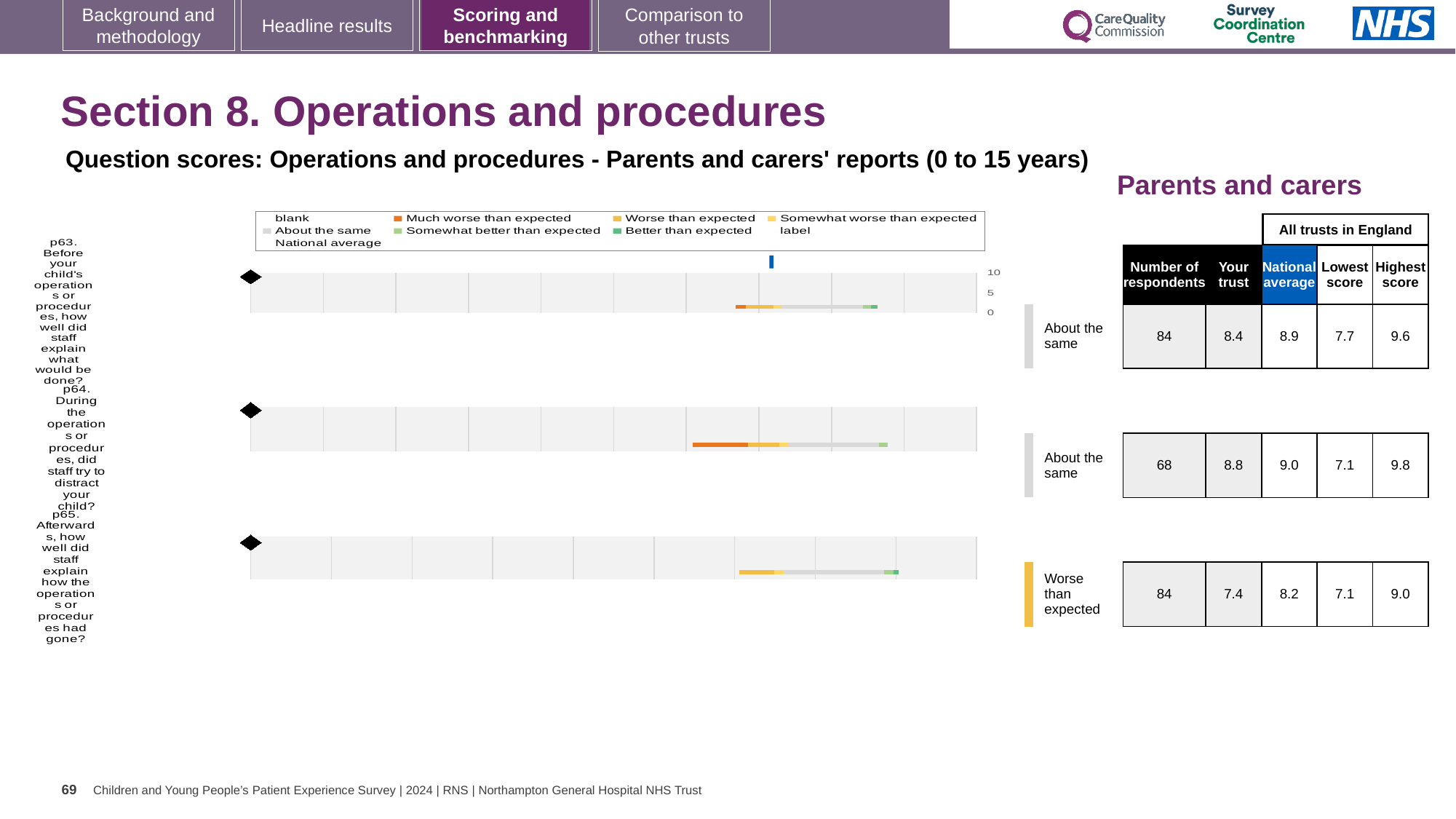
What is the highest value shown on the chart's score axis? 10 Which of the three questions has the highest 'Your trust' score? p64 What is the national average score for p64 (During the operations or procedures, did staff try to distract your child?)? 9.0 What is the difference between the national average and the 'Your trust' score for p65? 0.8 What is the 'Your trust' score for p63 (Before your child's operations or procedures, how well did staff explain what would be done?)? 8.4 Which benchmark category is shown for p65 (Afterwards, how well did staff explain how the operations or procedures had gone?)? Worse than expected What is the highest score across all trusts in England for p65? 9.0 Which of the three questions has the lowest 'Your trust' score? p65 For p63, which is larger: the 'Your trust' score or the national average? National average What kind of chart is used to show the question scores for operations and procedures? bar chart How many respondents answered p64? 68 How many questions (p63, p64, p65) are plotted in the chart? 3